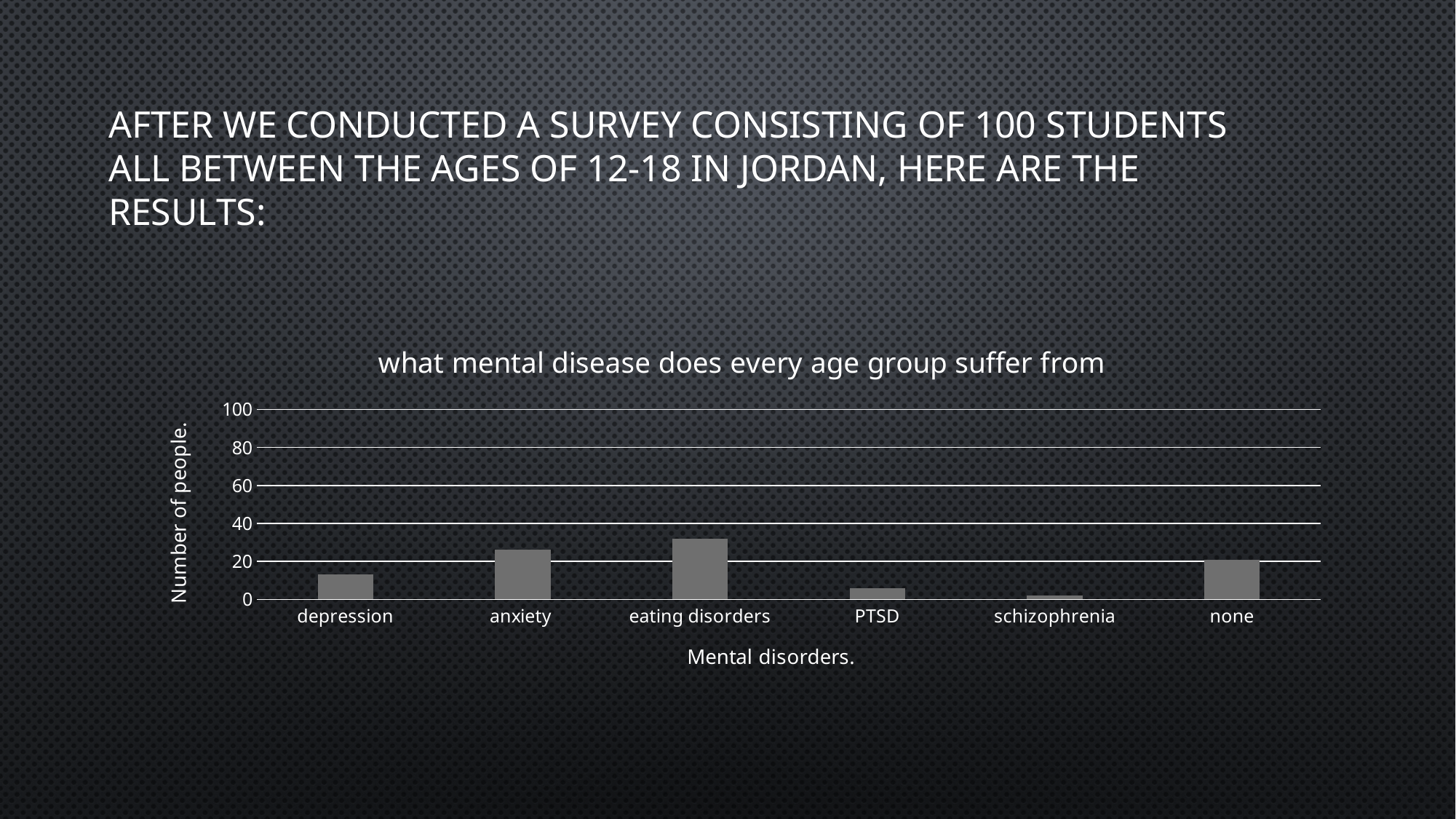
Is the value for eating disorders greater or less than 40? less Which category has the highest bar in the chart? eating disorders Is the value for depression greater or less than 20? less What kind of chart is shown on the slide? bar chart What is the label of the vertical axis of the chart? Number of people. Which is larger, the value for PTSD or the value for none? none Is the value for anxiety greater or less than 20? greater How many mental disorder categories are shown on the x axis of the chart? 6 What is the title of the chart? what mental disease does every age group suffer from Which category has the lowest bar in the chart? schizophrenia Which is larger, the value for anxiety or the value for depression? anxiety